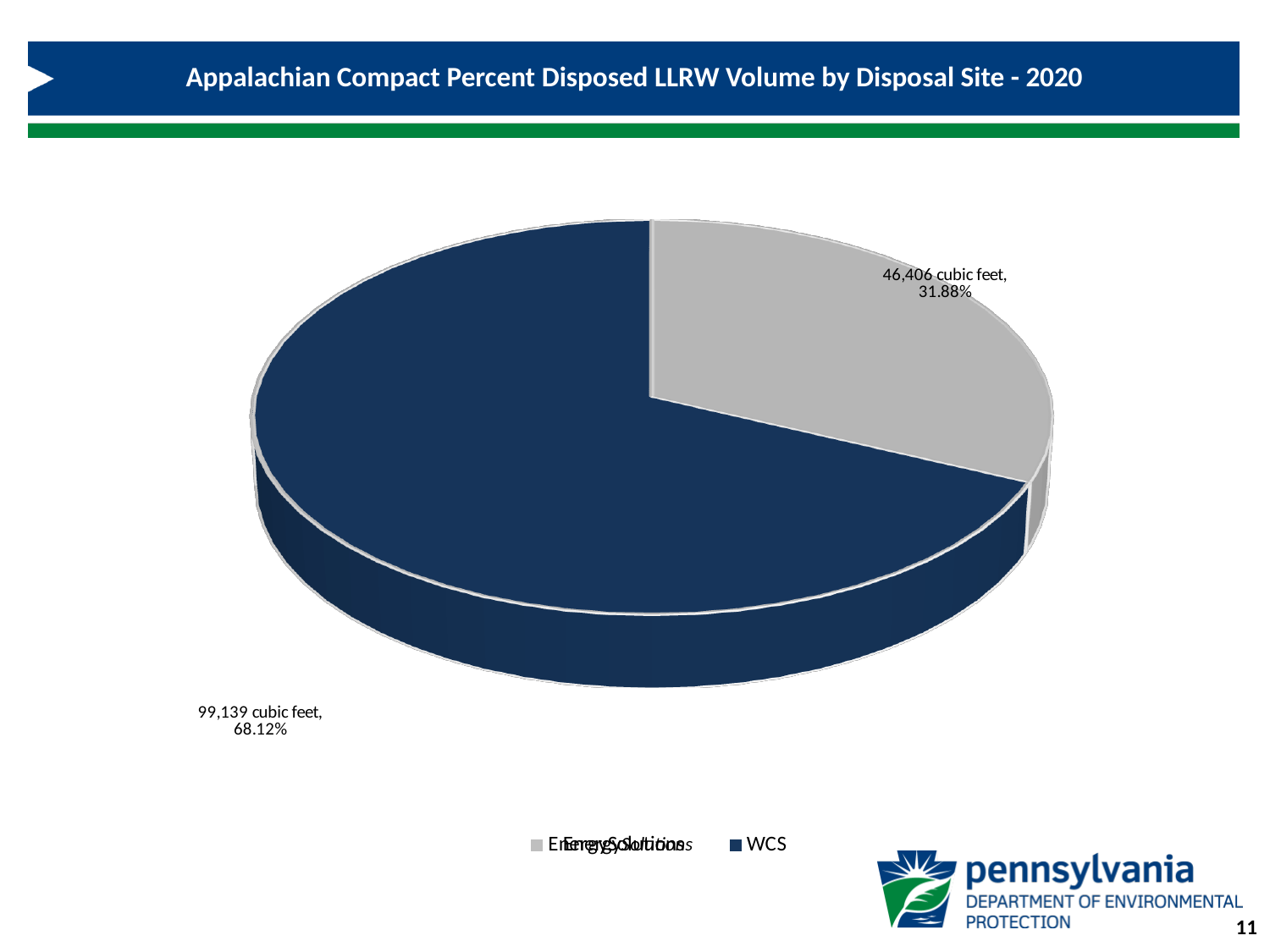
Which disposal site has the largest share of the pie? WCS What volume is shown for the WCS slice? 99,139 cubic feet What is the total volume represented by both slices of the pie? 145,545 cubic feet What percentage share does the grey slice have? 31.88% How many entries does the legend list? 2 What volume is shown for the grey slice? 46,406 cubic feet Which slice is larger, the dark blue WCS slice or the grey slice? WCS How many slices does the pie chart have? 2 What is the difference in volume between the WCS slice and the grey slice? 52,733 cubic feet What percentage share does the WCS slice have? 68.12% What is the title of the chart? Appalachian Compact Percent Disposed LLRW Volume by Disposal Site - 2020 What kind of chart is shown on the slide? Pie chart